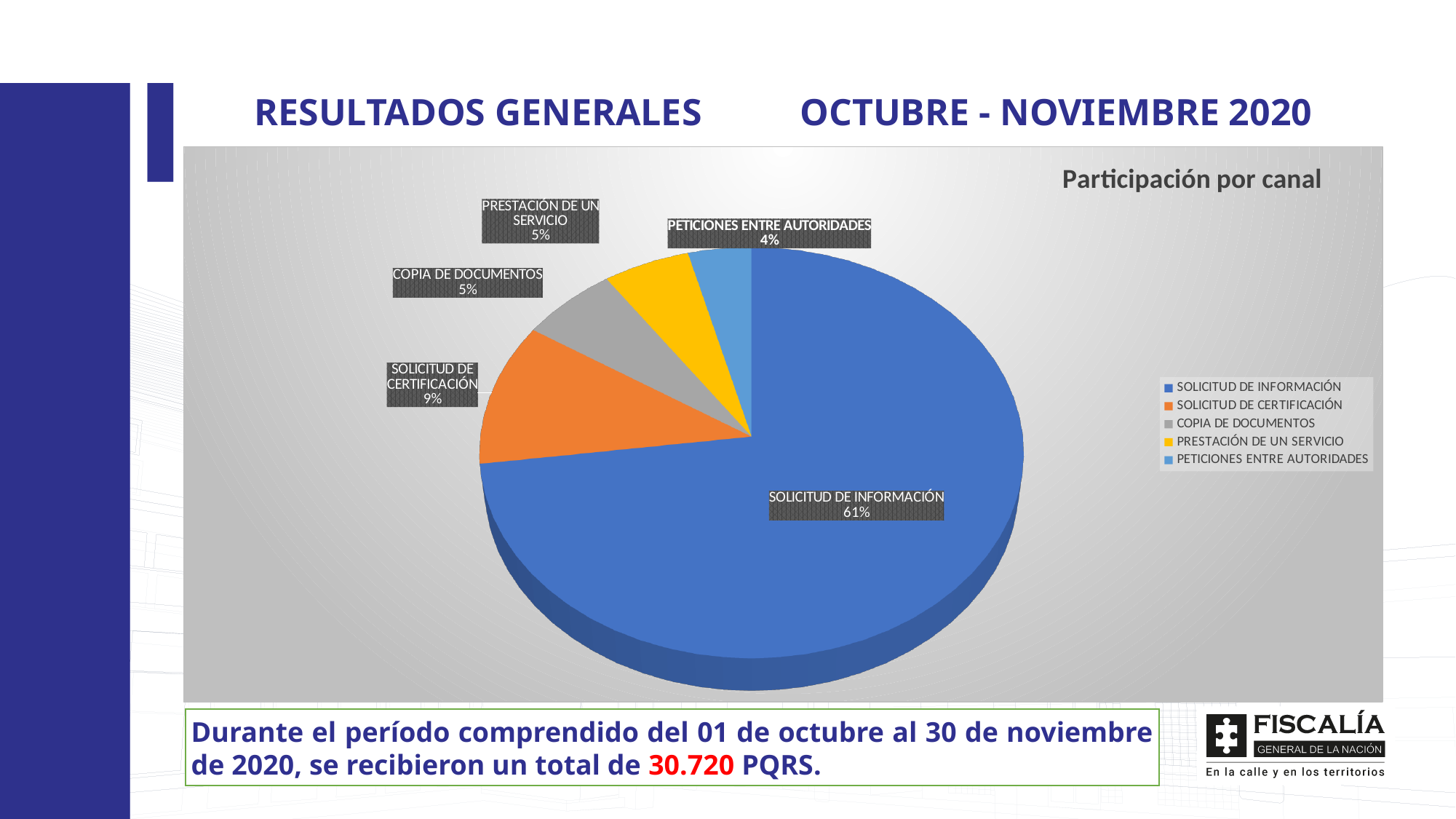
Which category has the smallest slice of the pie? PETICIONES ENTRE AUTORIDADES What share of the pie does SOLICITUD DE INFORMACIÓN represent? 61% What share of the pie does COPIA DE DOCUMENTOS represent? 5% What is the title of the chart? Participación por canal What colour is the slice for PRESTACIÓN DE UN SERVICIO? Yellow Which is larger, the share for SOLICITUD DE CERTIFICACIÓN or the share for PRESTACIÓN DE UN SERVICIO? SOLICITUD DE CERTIFICACIÓN What share of the pie does PETICIONES ENTRE AUTORIDADES represent? 4% What type of chart is shown on the slide? Pie chart Which category has the largest slice of the pie? SOLICITUD DE INFORMACIÓN What is the difference in percentage points between SOLICITUD DE INFORMACIÓN and SOLICITUD DE CERTIFICACIÓN? 52 How many categories does the pie chart have? 5 What share of the pie does SOLICITUD DE CERTIFICACIÓN represent? 9%